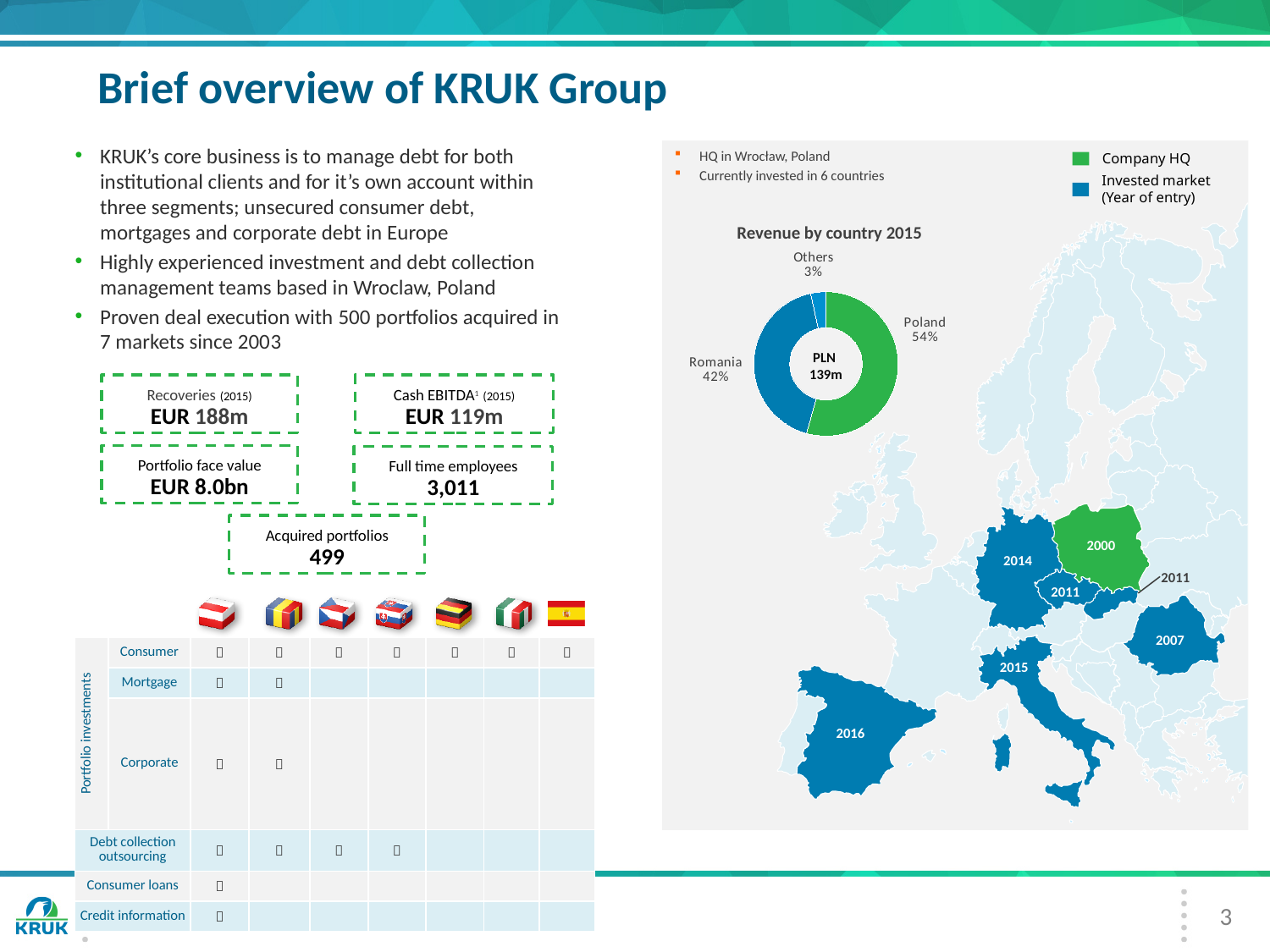
Which category has the smallest share of revenue in 2015? Others Which country has the largest share of revenue in 2015? Poland What total revenue figure is shown in the centre of the revenue by country 2015 chart? PLN 139m Which has a larger share of 2015 revenue, Romania or Others? Romania Is Romania's share of 2015 revenue greater or less than 50%? less What is the title of the chart on the slide? Revenue by country 2015 How many slices does the revenue by country 2015 chart have? 3 What share of revenue in 2015 came from Romania? 42% What kind of chart is used to show revenue by country 2015? Pie chart (donut) What share of revenue in 2015 came from Poland? 54% What share of revenue in 2015 came from Others? 3% How many percentage points larger is Poland's share than Romania's share of 2015 revenue? 12